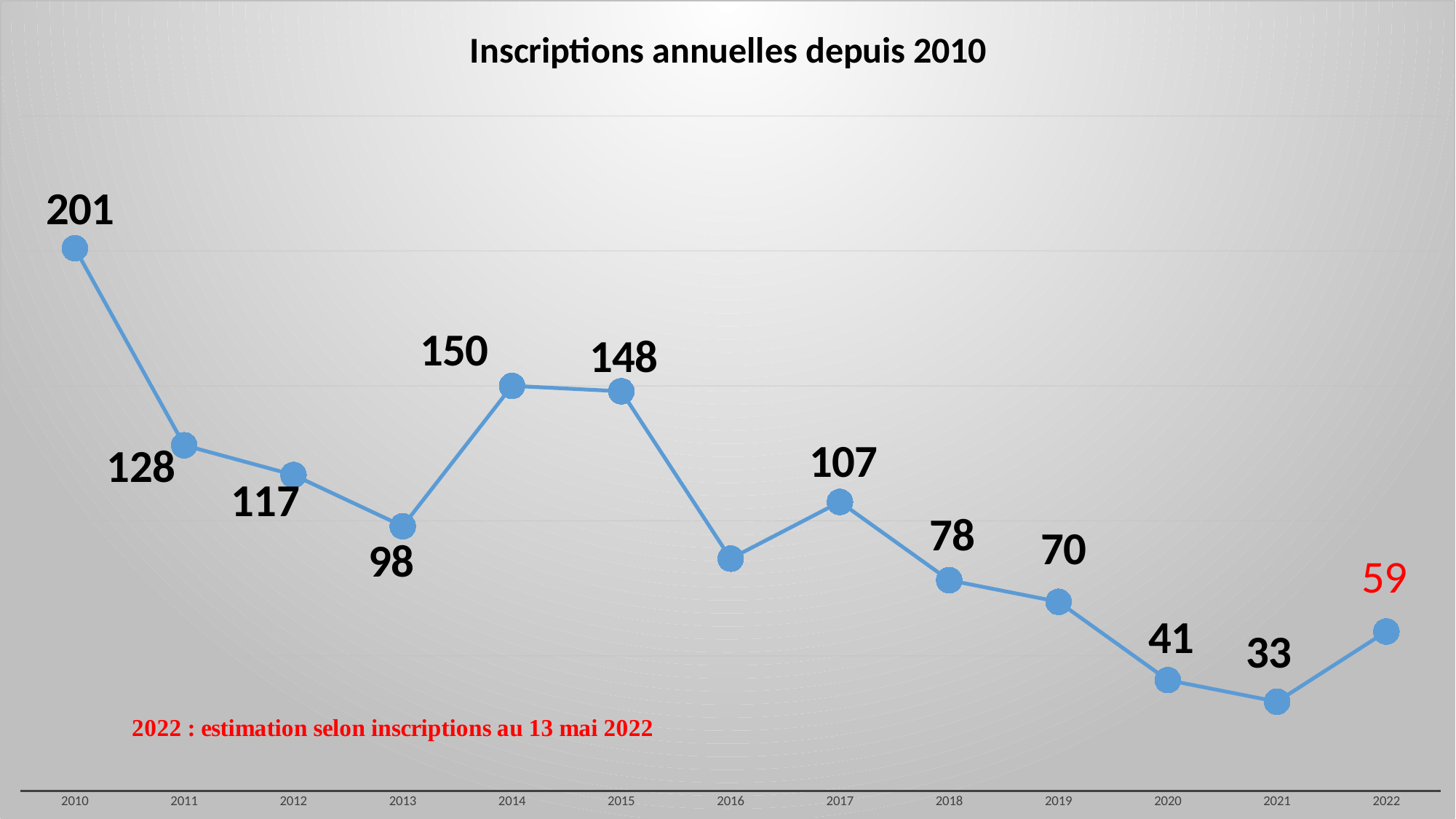
How many years are plotted on the x axis? 13 Which year has the lowest value? 2021 What is the title of the chart? Inscriptions annuelles depuis 2010 What is the value for 2021? 33 Do the values generally rise or fall from 2010 to 2021? fall What is the difference between the values for 2010 and 2011? 73 Which year has the highest value? 2010 Which is larger, the value for 2017 or the value for 2018? 2017 What type of chart is shown on the slide? line chart What is the estimated value shown for 2022? 59 What is the value for 2010? 201 What is the value for 2014? 150